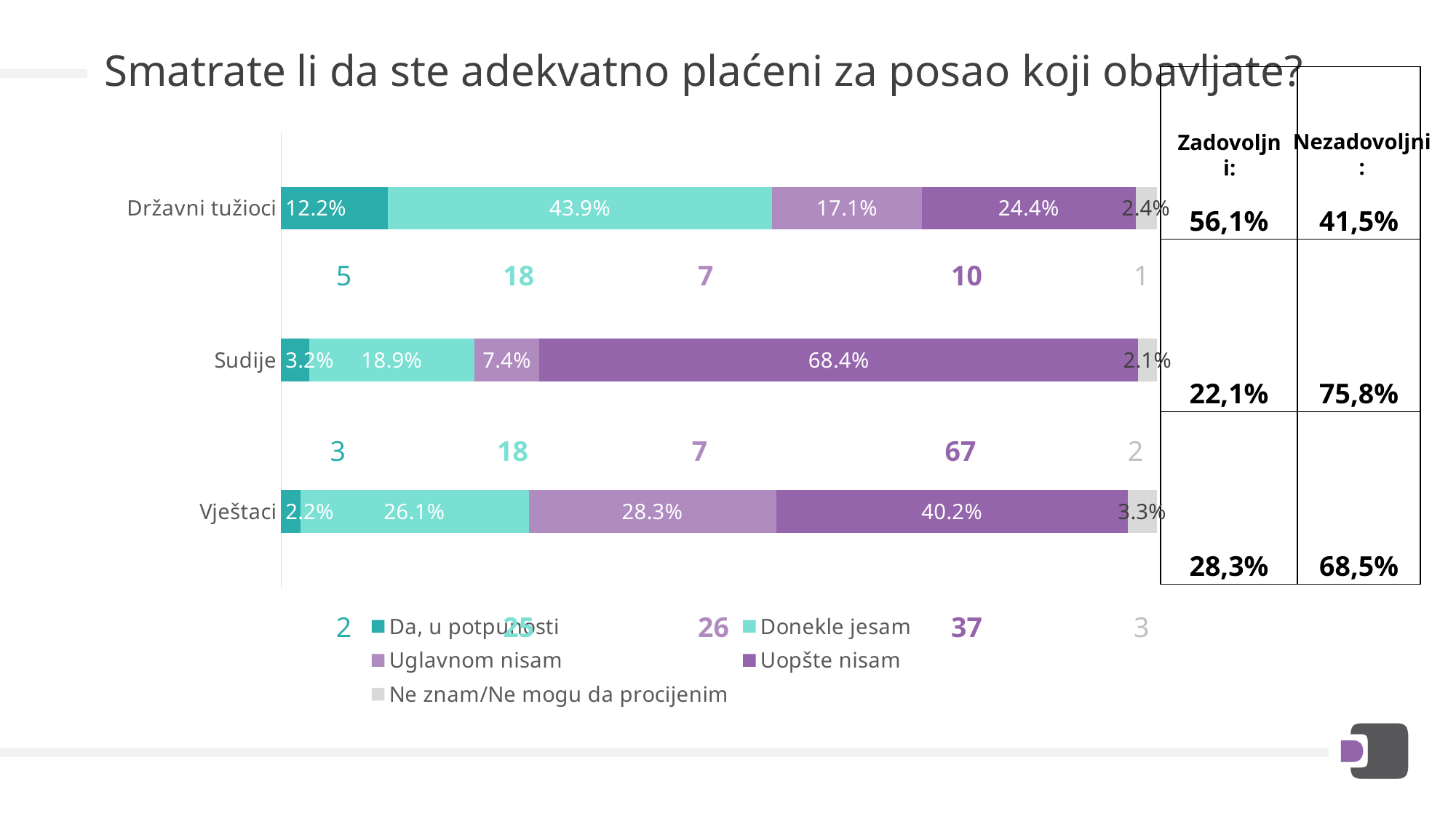
What is the value for "Donekle jesam" for Državni tužioci? 43.9% Which is larger: the "Donekle jesam" value for Državni tužioci or for Vještaci? Državni tužioci Which legend entry is shown in light grey? Ne znam/Ne mogu da procijenim Which category has the highest value for "Uopšte nisam"? Sudije What is the value for "Da, u potpunosti" for Sudije? 3.2% What is the difference between the "Uopšte nisam" values for Sudije and Vještaci? 28.2% Which category has the lowest value for "Da, u potpunosti"? Vještaci What is the value for "Uopšte nisam" for Sudije? 68.4% How many categories (groups of respondents) are plotted on the chart? 3 What kind of chart is shown on the slide? Stacked bar chart What is the value for "Uglavnom nisam" for Vještaci? 28.3% How many series does the chart legend list? 5